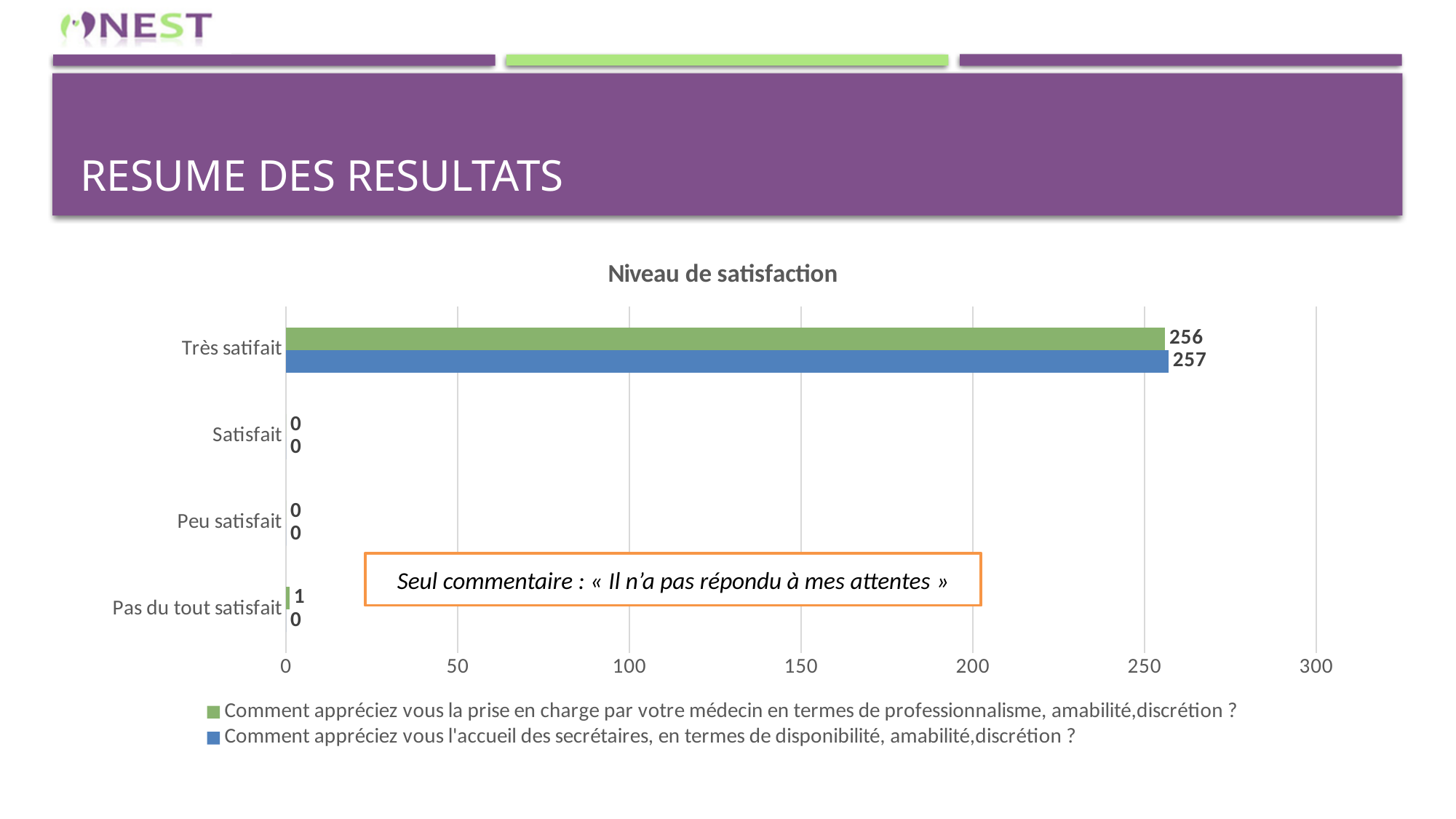
What is the difference between the two series' values for 'Très satifait'? 1 Which category has the highest value in the series about the secrétaires (blue)? Très satifait What is the value for 'Pas du tout satisfait' in the series about the médecin (green)? 1 How many series does the legend list? 2 What is the total of the two series' values for 'Pas du tout satisfait'? 1 What is the value for 'Très satifait' in the series about the médecin (green)? 256 What type of chart is shown on the slide? bar chart What is the value for 'Satisfait' in the series about the secrétaires (blue)? 0 What is the title of the chart? Niveau de satisfaction Is the value for 'Très satifait' in the green series greater or less than 250? greater What is the value for 'Très satifait' in the series about the secrétaires (blue)? 257 How many categories are shown on the vertical axis? 4